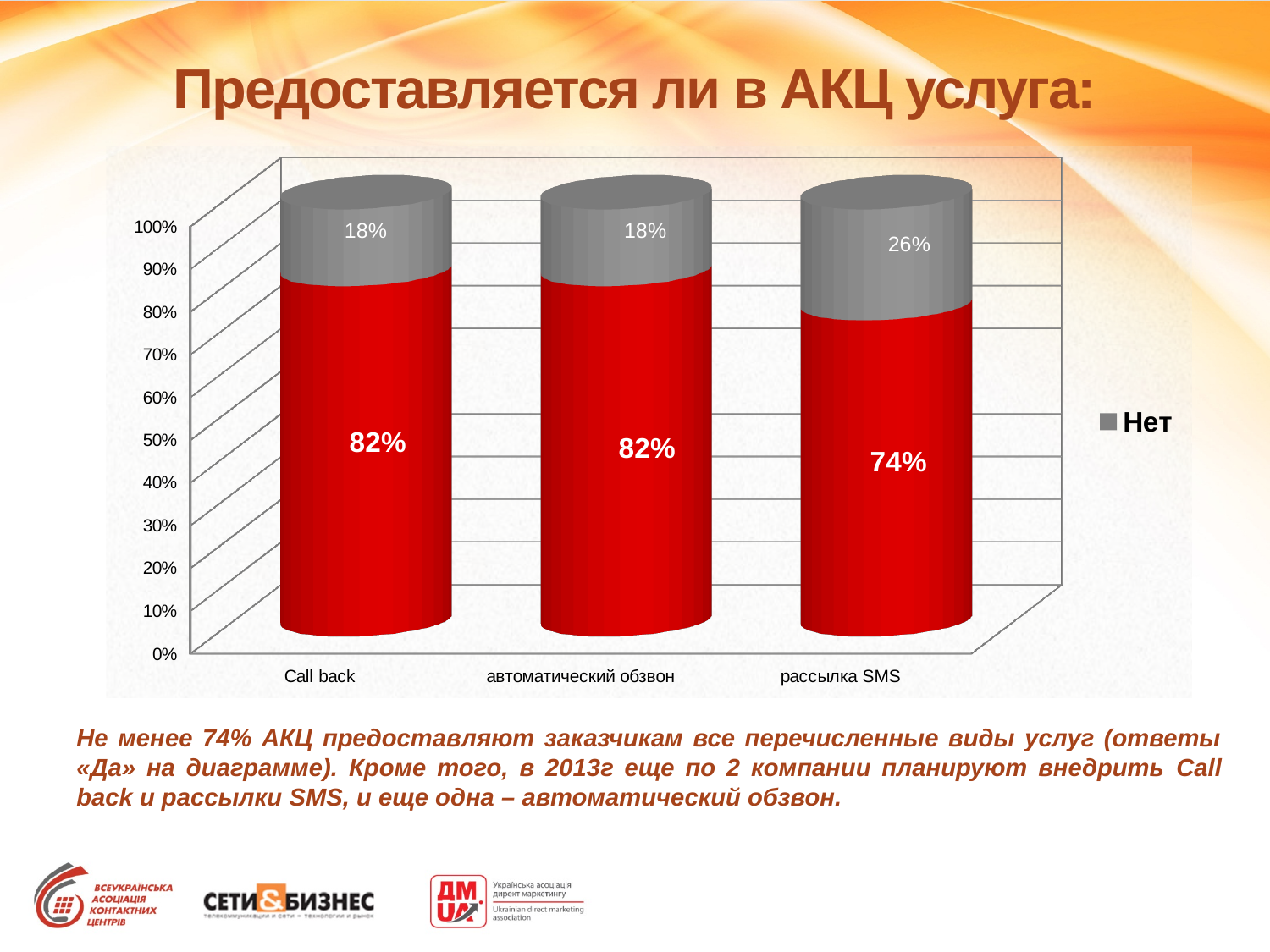
What is the total of the stacked bar for автоматический обзвон? 100% What is the value of the grey segment for автоматический обзвон? 18% What is the value of the grey segment for рассылка SMS? 26% Which category has the highest grey segment value? рассылка SMS What is the difference between the red segment for Call back and the red segment for рассылка SMS? 8% What is the title of the chart slide? Предоставляется ли в АКЦ услуга: Which has a larger grey segment: Call back or рассылка SMS? рассылка SMS How many categories are shown on the x axis? 3 What kind of chart is shown on the slide? Stacked bar chart What is the value of the red segment for рассылка SMS? 74% Which category has the lowest red segment value? рассылка SMS What is the value of the red segment for Call back? 82%